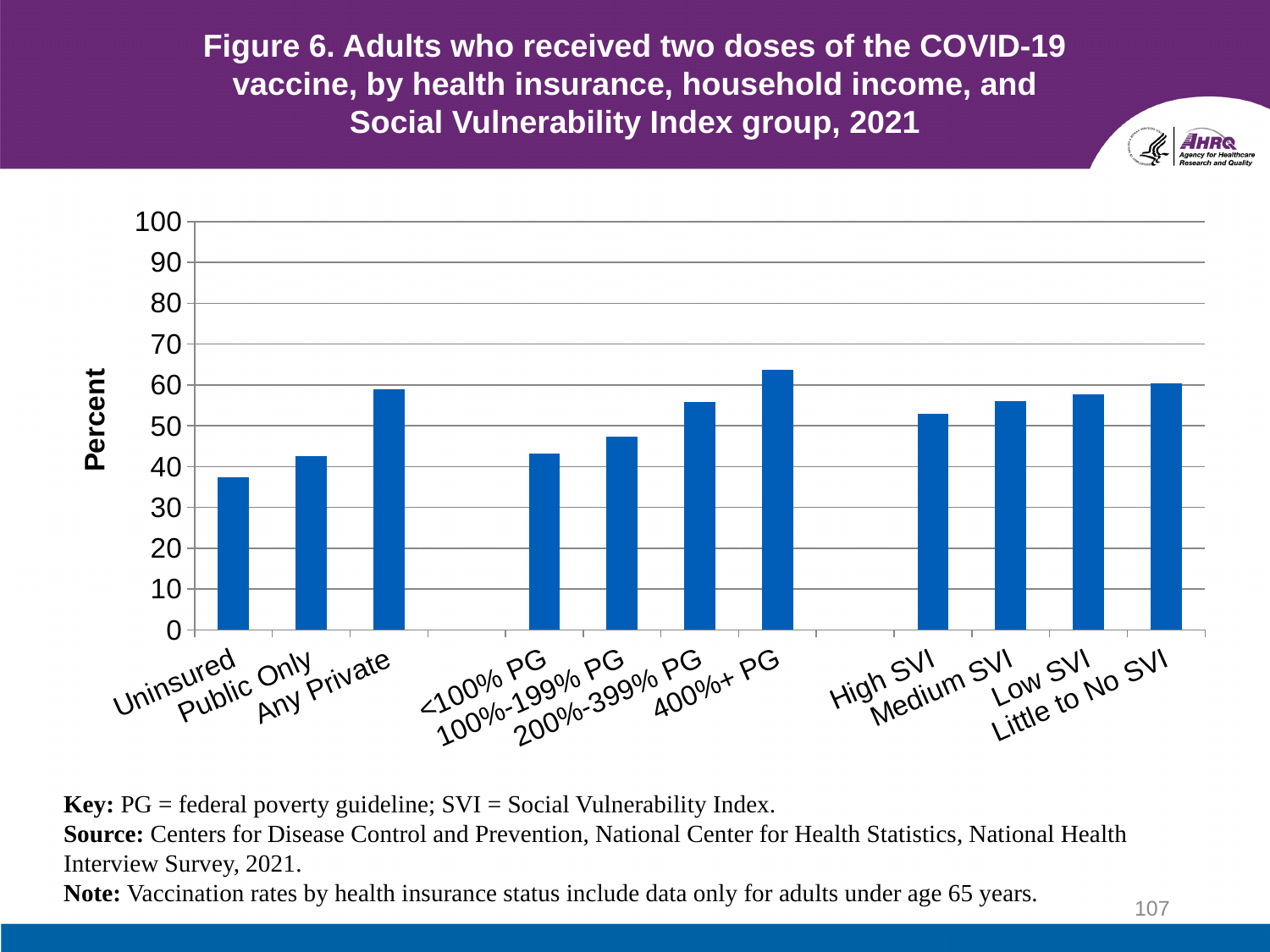
Do the values rise or fall across the household income groups from <100% PG to 400%+ PG? rise Is the value for <100% PG greater or less than 50? less Is the value for Uninsured greater or less than 40? less Which is larger, the value for High SVI or the value for Little to No SVI? Little to No SVI Is the value for 400%+ PG greater or less than 60? greater What kind of chart is shown on the slide? bar chart How many categories (bars) are plotted in the chart? 11 Which is larger, the value for Public Only or the value for Any Private? Any Private Which category has the lowest value in the chart? Uninsured What is the label on the vertical axis of the chart? Percent Which category has the highest value in the chart? 400%+ PG